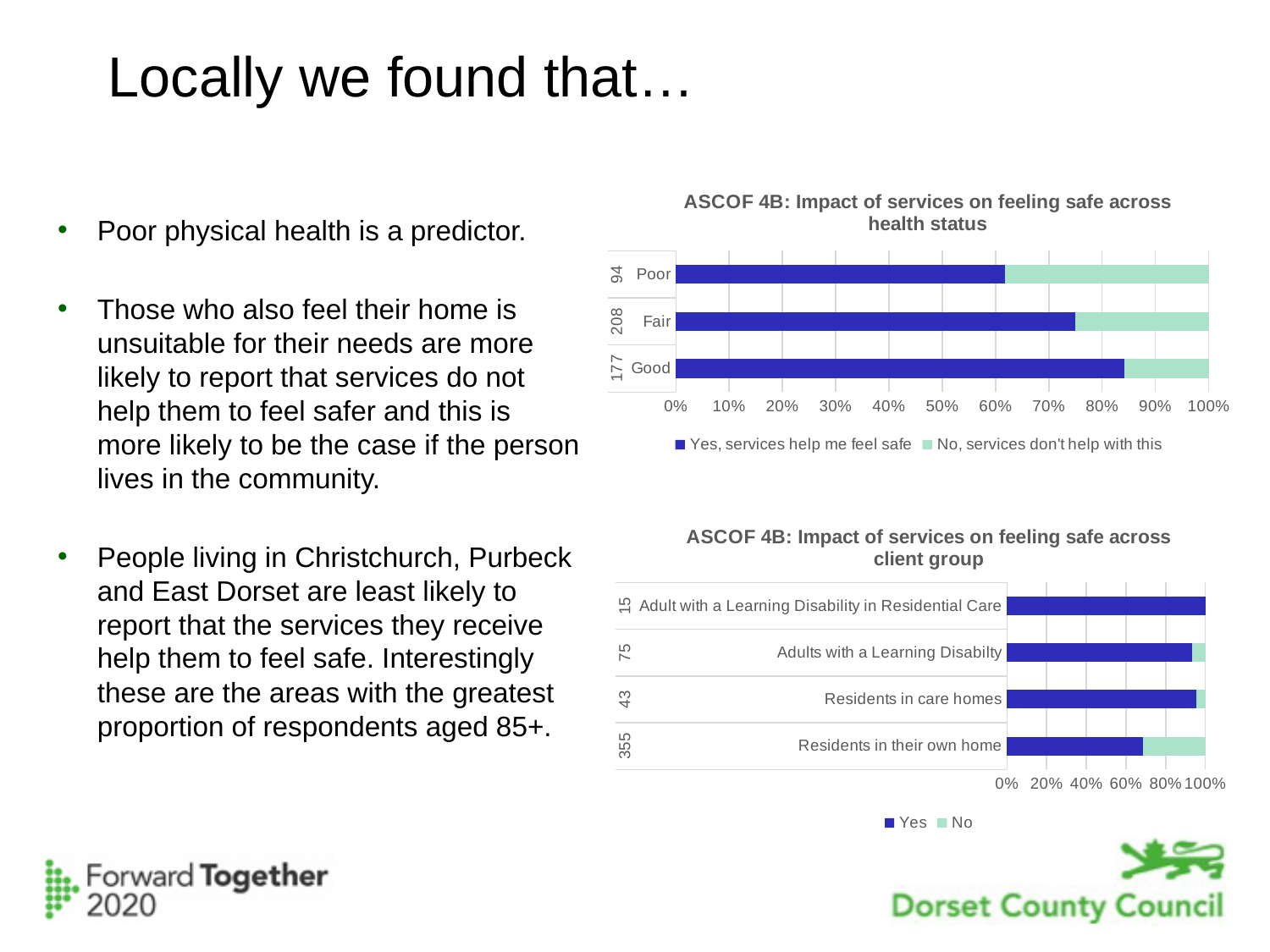
In the chart 'ASCOF 4B: Impact of services on feeling safe across client group', is the 'Yes' share for Residents in their own home greater or less than 80%? less In the chart 'ASCOF 4B: Impact of services on feeling safe across health status', what kind of chart is shown? Stacked bar chart In the chart 'ASCOF 4B: Impact of services on feeling safe across health status', is the 'Yes, services help me feel safe' share for Poor greater or less than 70%? less In the chart 'ASCOF 4B: Impact of services on feeling safe across health status', which health status has the lowest share of 'Yes, services help me feel safe'? Poor In the chart 'ASCOF 4B: Impact of services on feeling safe across health status', is the 'Yes, services help me feel safe' share for Good greater or less than 80%? greater In the chart 'ASCOF 4B: Impact of services on feeling safe across client group', how many client groups are plotted? 4 In the chart 'ASCOF 4B: Impact of services on feeling safe across health status', how many series does the legend list? 2 In the chart 'ASCOF 4B: Impact of services on feeling safe across health status', which is larger: the 'Yes' share for Fair or the 'Yes' share for Poor? Fair In the chart 'ASCOF 4B: Impact of services on feeling safe across health status', how many health status categories are plotted? 3 In the chart 'ASCOF 4B: Impact of services on feeling safe across client group', which client group has the lowest 'Yes' share? Residents in their own home In the chart 'ASCOF 4B: Impact of services on feeling safe across client group', what are the two legend entries? Yes and No In the chart 'ASCOF 4B: Impact of services on feeling safe across health status', which health status has the highest share of 'Yes, services help me feel safe'? Good